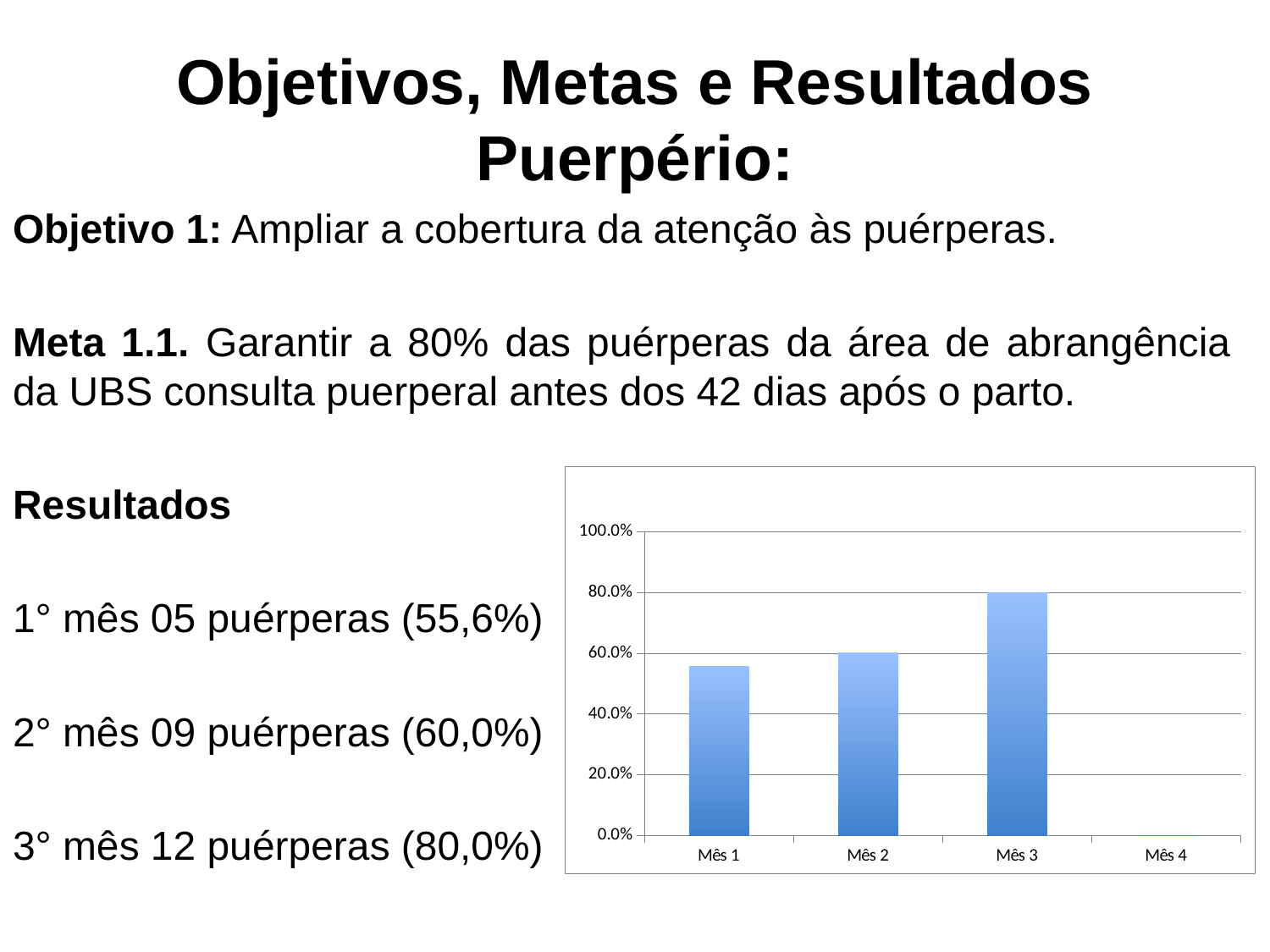
What is the value for Mês 2 in the chart? 60.0% Which is larger, the value for Mês 2 or the value for Mês 3? Mês 3 Is the value for Mês 1 greater or less than 60.0%? less What is the highest value shown on the chart's y axis? 100.0% How many categories are shown on the x axis of the chart? 4 Is the value for Mês 1 greater or less than 40.0%? greater Which of the three plotted bars (Mês 1, Mês 2, Mês 3) is the shortest? Mês 1 What kind of chart is shown on the slide? bar chart Which month has the highest bar in the chart? Mês 3 Do the bar values rise or fall from Mês 1 to Mês 3? rise What is the difference between the values for Mês 3 and Mês 2? 20.0% What is the value for Mês 3 in the chart? 80.0%